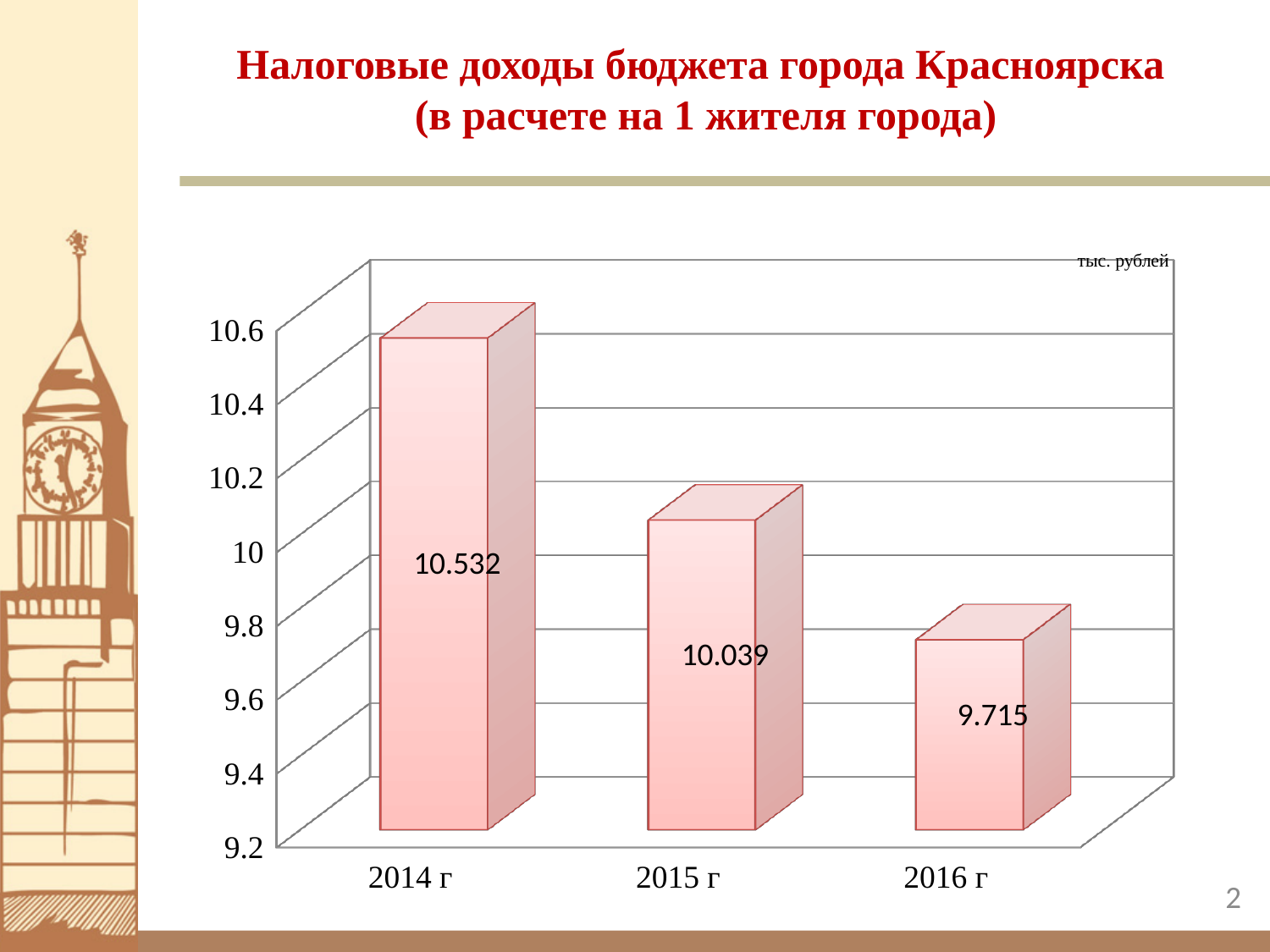
What is the value for 2015 г? 10.039 Is the value for 2016 г greater or less than 10? less Which year has the highest value? 2014 г What is the difference between the values for 2014 г and 2015 г? 0.493 Which is larger, the value for 2015 г or the value for 2016 г? 2015 г What is the value for 2014 г? 10.532 Which year has the lowest value? 2016 г How many years are shown on the chart? 3 What is the value for 2016 г? 9.715 What kind of chart is shown on the slide? bar chart Do the values rise or fall from 2014 г to 2016 г? fall What is the difference between the values for 2014 г and 2016 г? 0.817